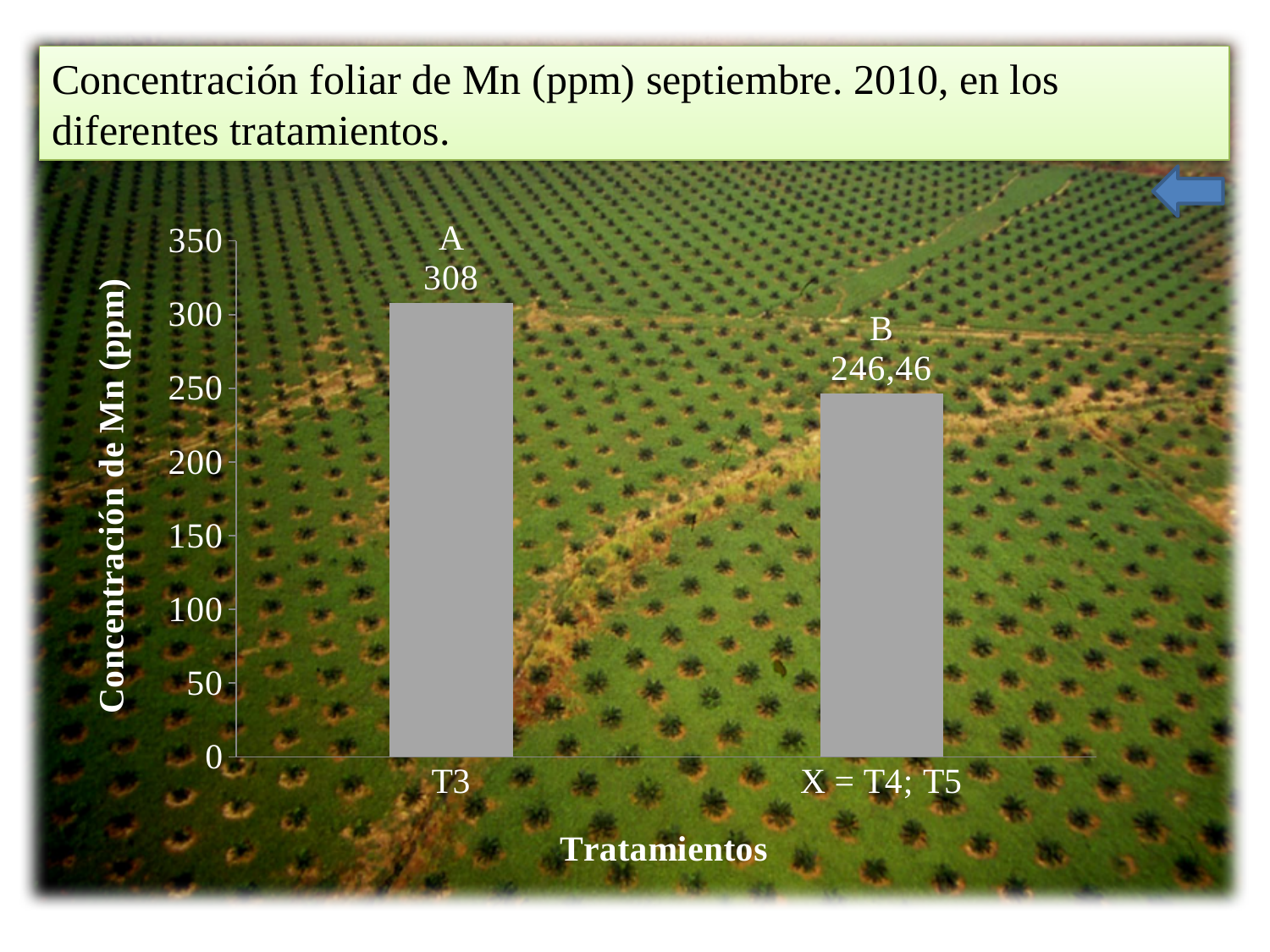
What letter is printed above the bar for T3? A Which treatment category has the lowest Mn concentration? X = T4; T5 What is the Mn concentration value shown for the category labelled "X = T4; T5"? 246,46 Which treatment category has the highest Mn concentration? T3 How many treatment categories are plotted on the chart? 2 Is the value for X = T4; T5 greater or less than 250? less What is the difference between the Mn concentration for T3 and for X = T4; T5? 61,54 What is the label of the vertical axis of the chart? Concentración de Mn (ppm) What is the Mn concentration value shown for treatment T3? 308 Which has a larger Mn concentration, T3 or X = T4; T5? T3 What kind of chart is shown on the slide? Bar chart Is the value for T3 greater or less than 300? greater